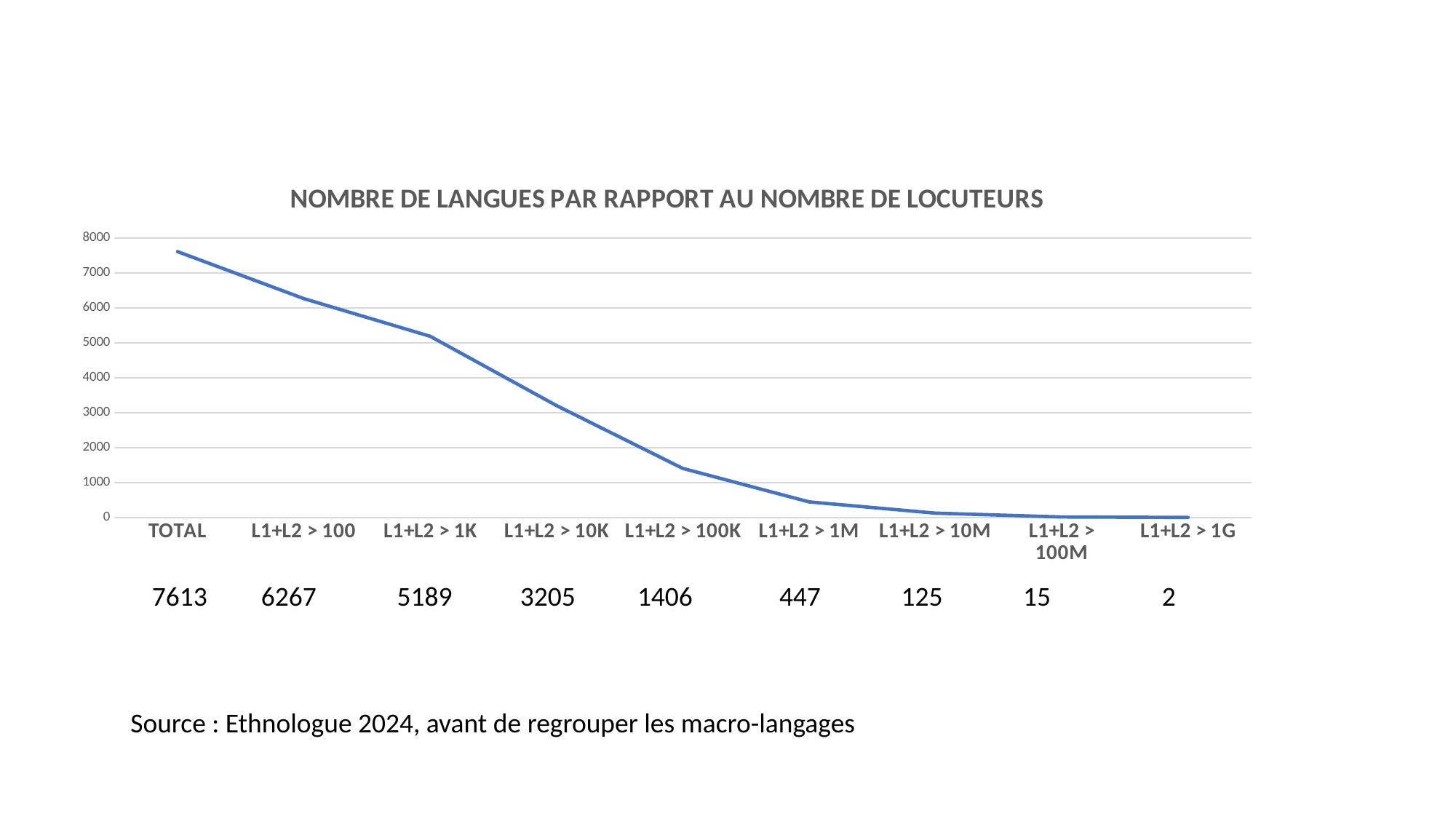
Do the values rise or fall from left to right along the x axis? fall What is the value for L1+L2 > 1K? 5189 What is the value for L1+L2 > 100K? 1406 Which category has the highest value? TOTAL What is the value for L1+L2 > 1G? 2 How many categories are plotted on the x axis? 9 What is the value for TOTAL? 7613 What is the difference between the values for L1+L2 > 100 and L1+L2 > 1K? 1078 Is the value for L1+L2 > 10K greater or less than 3000? greater Which category has the lowest value? L1+L2 > 1G What kind of chart is shown? line chart Which is larger, the value for L1+L2 > 10K or the value for L1+L2 > 1M? L1+L2 > 10K